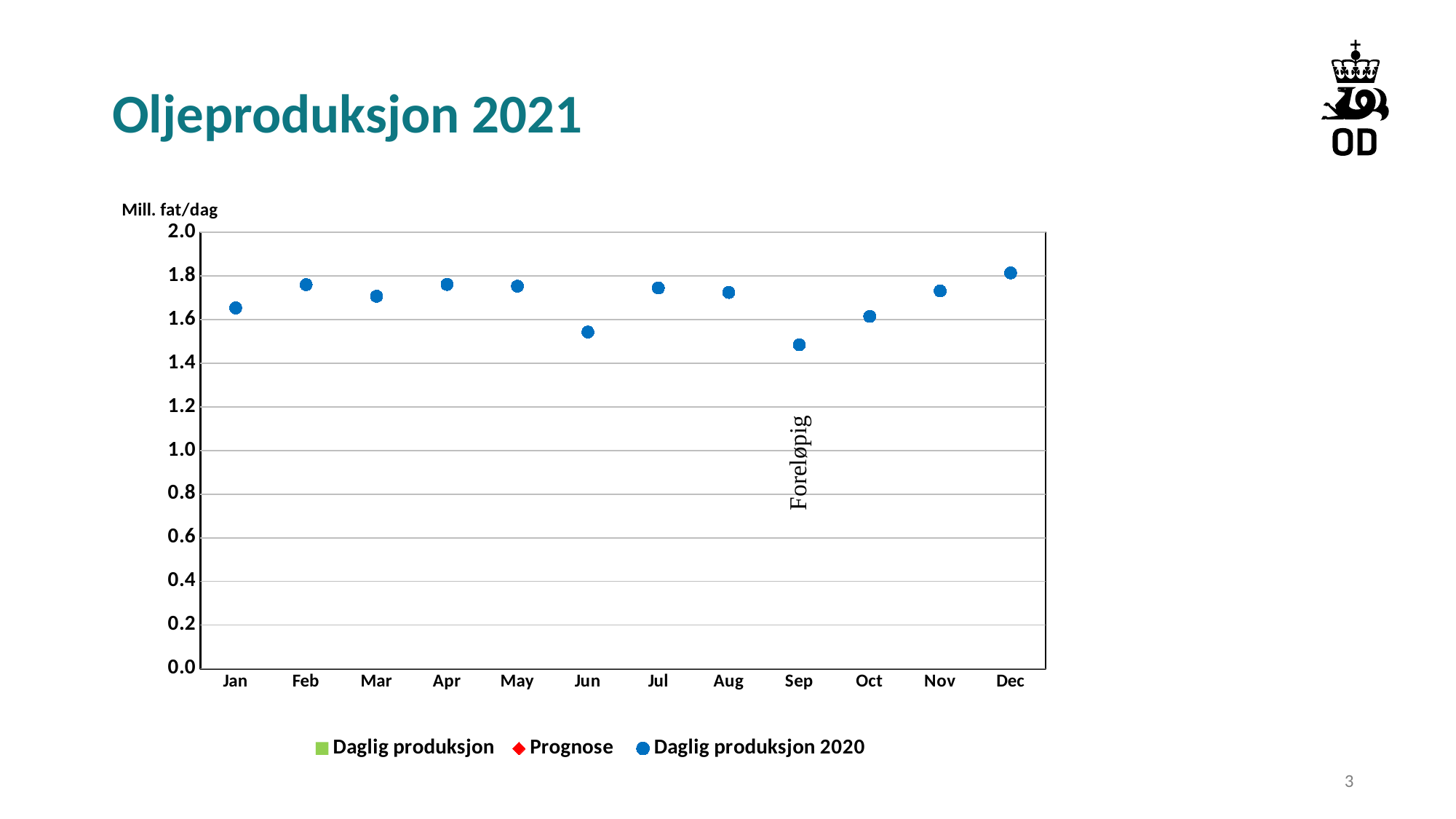
How many series does the legend list? 3 Is the value for Jan greater or less than 1.6? greater Is the value for Jun greater or less than 1.6? less Is the value for Oct greater or less than 1.8? less Which is larger, the value for Jun or the value for Sep? Jun Which month has the highest value for Daglig produksjon 2020? Dec Which month has the lowest value for Daglig produksjon 2020? Sep Do the values rise or fall from Sep to Dec? rise How many months are plotted on the x axis? 12 What unit is shown on the y axis label? Mill. fat/dag What kind of chart is shown on the slide? Scatter (dot) chart